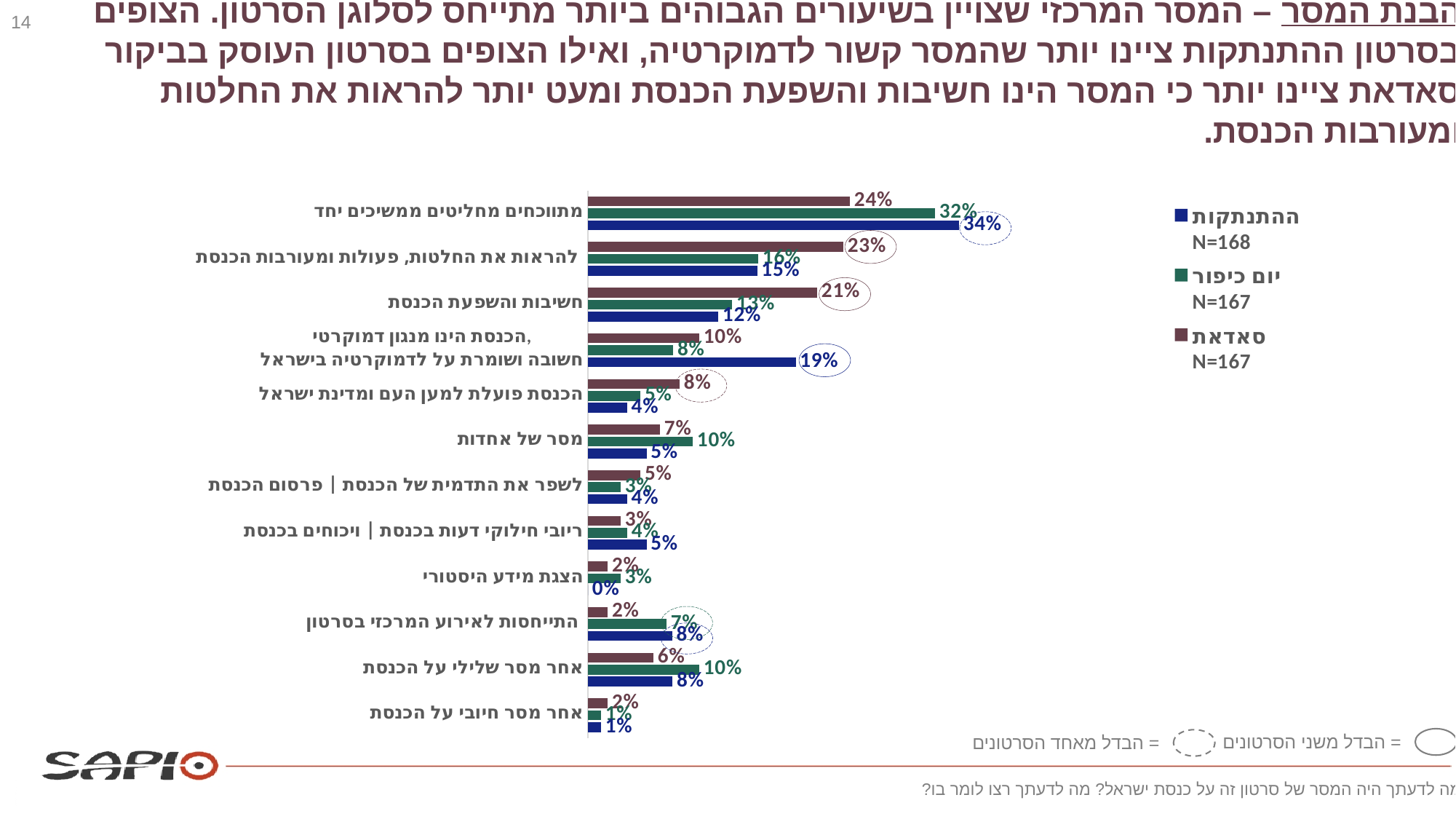
What colour are the bars for the יום כיפור series? green Which category has the highest value for the סאדאת series? מתווכחים מחליטים ממשיכים יחד What is the difference between the ההתנתקות and יום כיפור values in the category הכנסת הינו מנגון דמוקרטי, חשובה ושומרת על לדמוקרטיה בישראל? 11% In the category להראות את החלטות, פעולות ומעורבות הכנסת, which series has the larger value: סאדאת or ההתנתקות? סאדאת How many series does the legend list? 3 What is the value for סאדאת in the category חשיבות והשפעת הכנסת? 21% Which category has the lowest value for the ההתנתקות series? הצגת מידע היסטורי How many categories are plotted on the chart? 12 What is the value for ההתנתקות in the category מתווכחים מחליטים ממשיכים יחד? 34% What type of chart is shown on the slide? bar chart What is the value for יום כיפור in the category מסר של אחדות? 10% What is the sample size (N) shown in the legend for the ההתנתקות series? N=168